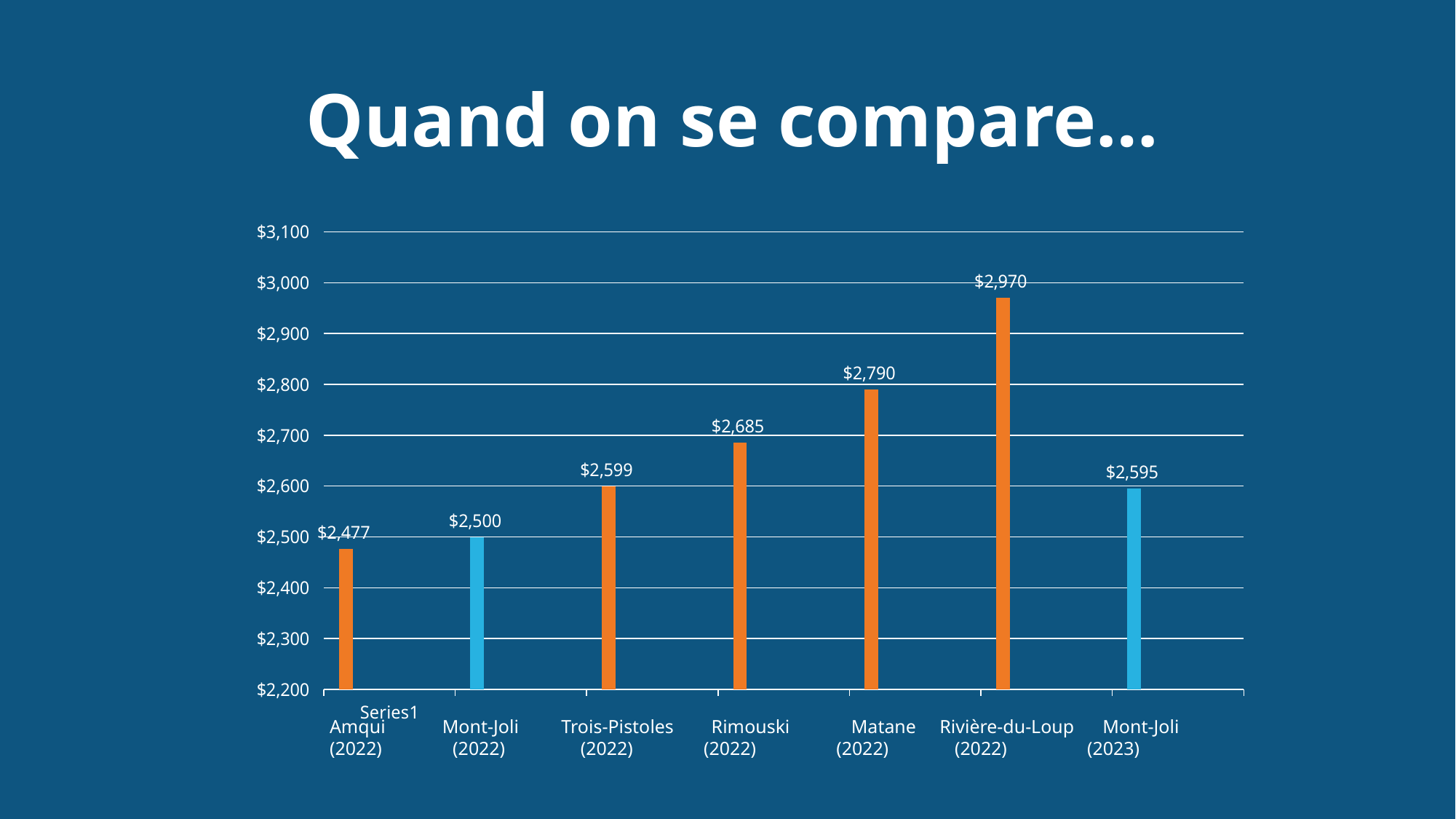
What is the value for Mont-Joli (2023)? $2,595 How many categories are shown on the x axis? 7 What is the difference between Mont-Joli (2023) and Mont-Joli (2022)? $95 Is the value for Matane (2022) greater or less than $2,700? greater What is the value for Amqui (2022)? $2,477 What is the difference between Rivière-du-Loup (2022) and Matane (2022)? $180 What kind of chart is shown on the slide? bar chart What is the value for Rimouski (2022)? $2,685 Which is larger, the value for Trois-Pistoles (2022) or the value for Mont-Joli (2023)? Trois-Pistoles (2022) Which category has the lowest value? Amqui (2022) What is the title of the slide? Quand on se compare... Which category has the highest value? Rivière-du-Loup (2022)